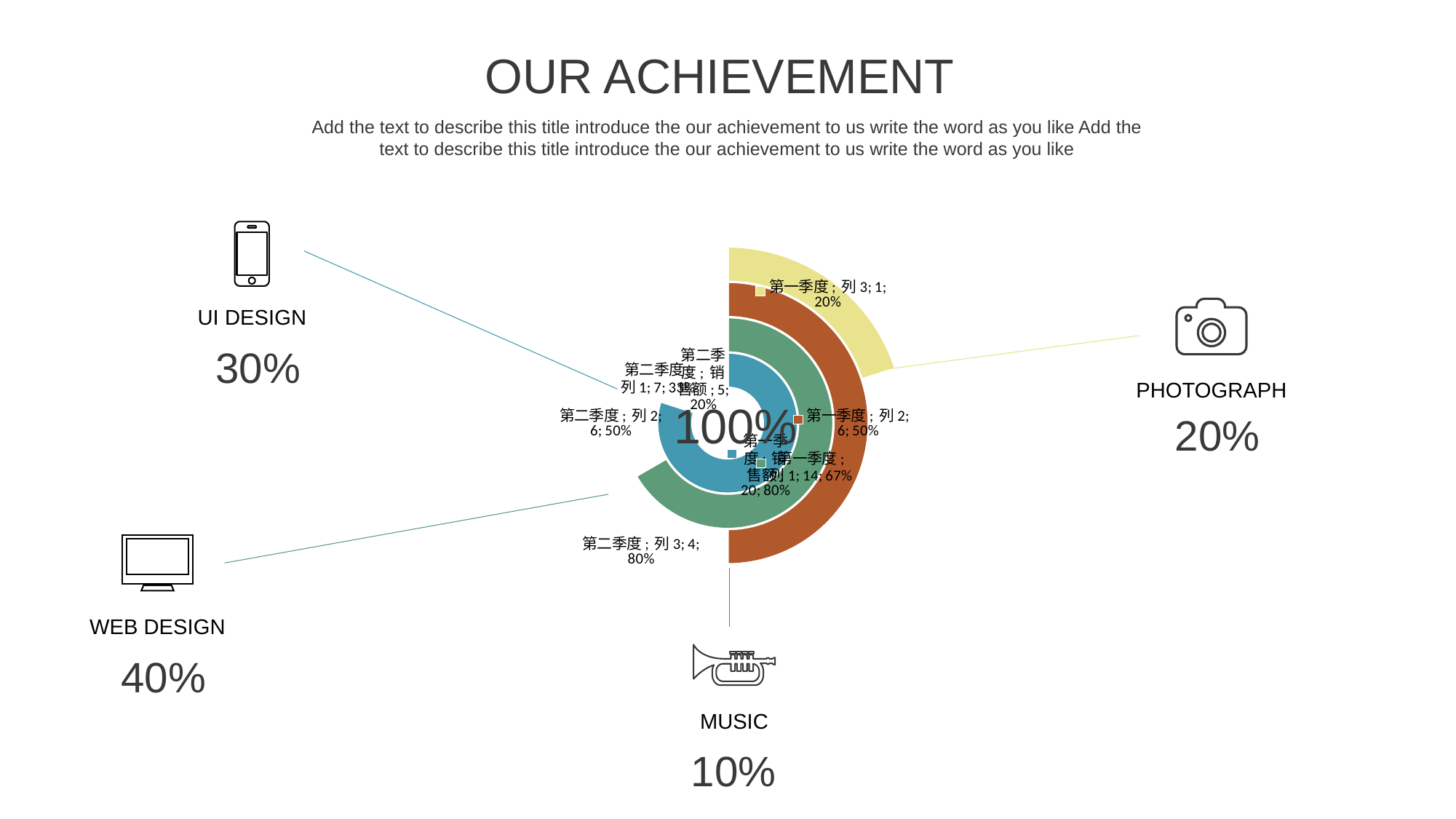
What value is shown in the data label for 第一季度, 列 2? 6 What value is shown in the data label for 第二季度, 列 3? 4 What colour is the outermost ring of the doughnut chart? yellow Which has the larger value for 列 3: 第一季度 or 第二季度? 第二季度 What percentage is shown in the data label for 第二季度, 列 2? 50% What kind of chart is shown on the slide? doughnut chart What is the difference between the 列 3 values for 第二季度 and 第一季度? 3 How many concentric rings does the doughnut chart have? 4 What percentage is shown in the data label for 第二季度, 列 3? 80% What percentage is shown in the data label for 第一季度, 列 3? 20% What text is displayed in the centre of the doughnut chart? 100%